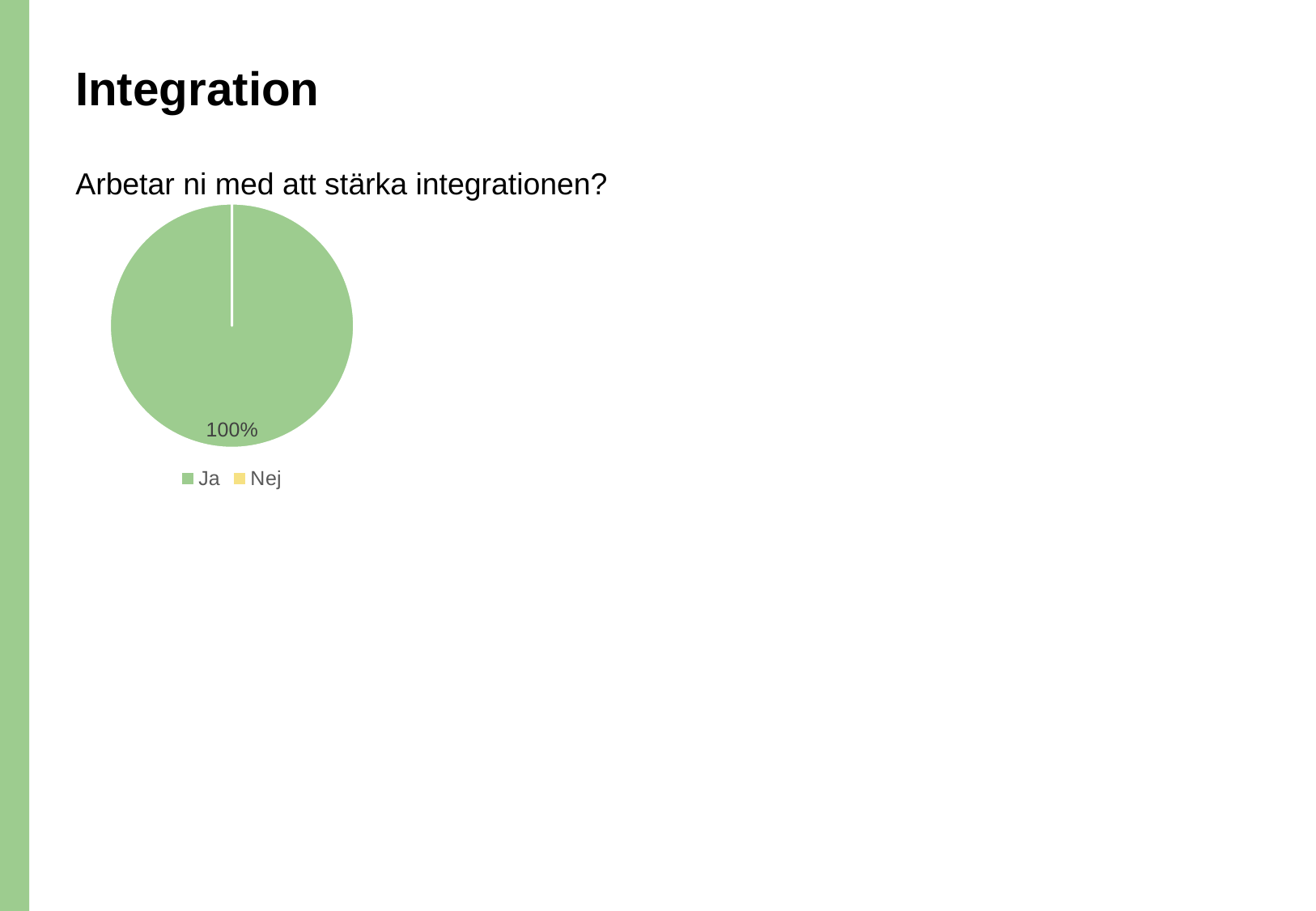
What is the value printed on the pie chart? 100% What kind of chart is shown on the slide? pie chart What question does the chart answer, as written above it? Arbetar ni med att stärka integrationen? Is the share for "Ja" greater or less than 50%? greater How many entries does the legend list? 2 Which is larger, the share for "Ja" or the share for "Nej"? Ja Which category has the largest share of the pie? Ja What share of the pie does "Ja" represent? 100% What colour represents "Ja" in the legend? green